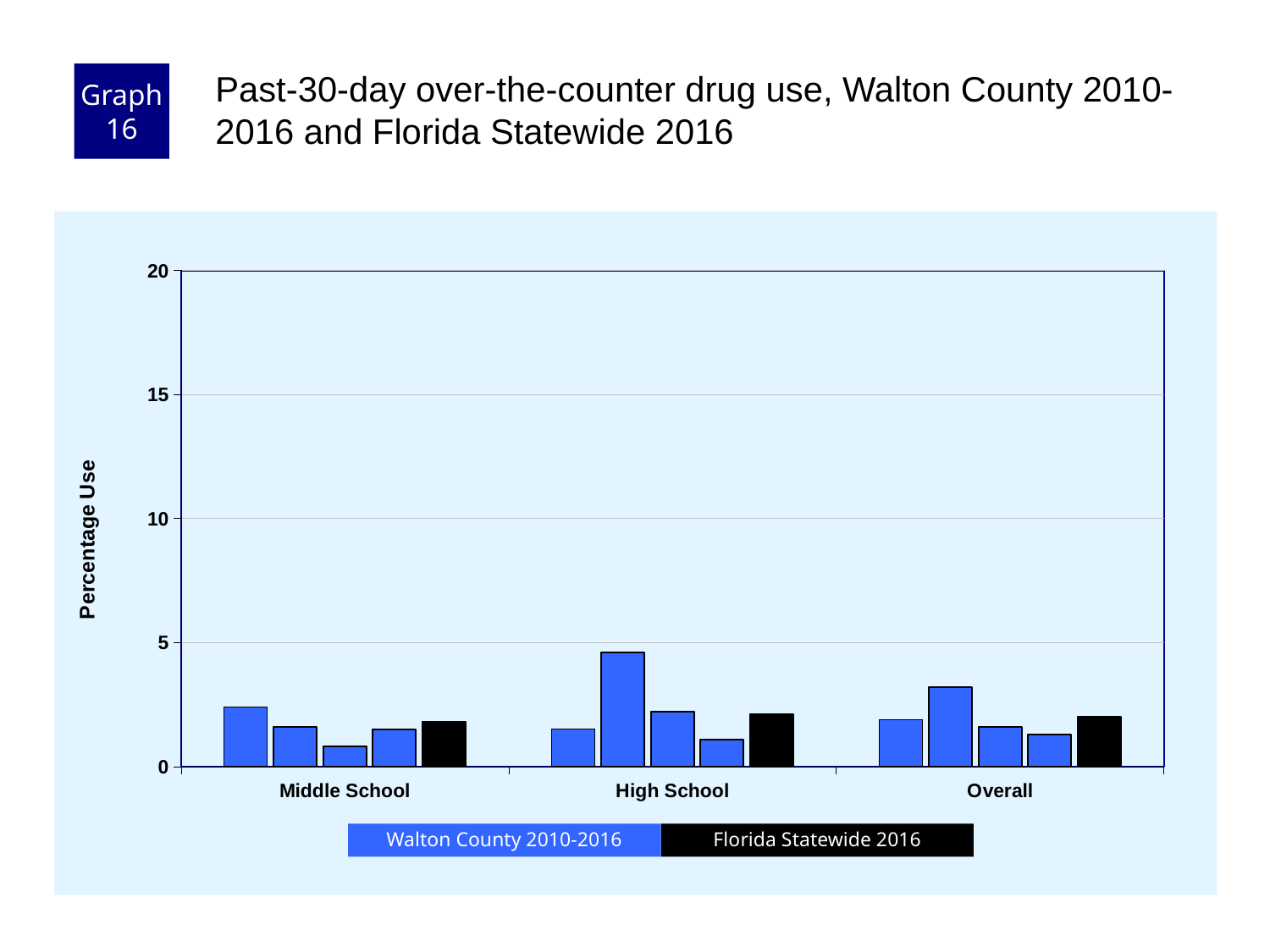
How many categories are shown on the x axis? 3 Is the Florida Statewide 2016 value for Overall greater or less than 10? less How many series does the legend list? 2 Which category contains the tallest bar on the chart? High School What colour are the Florida Statewide 2016 bars? black Is the tallest Walton County 2010-2016 bar for High School greater or less than 5? less How many bars are plotted for the High School category? 5 Which category contains the shortest bar on the chart? Middle School What kind of chart is shown on the slide? bar chart What is the label on the y axis? Percentage Use Which is larger: the tallest Walton County 2010-2016 bar for High School or the tallest Walton County 2010-2016 bar for Middle School? High School Is the Florida Statewide 2016 value for High School greater or less than 5? less